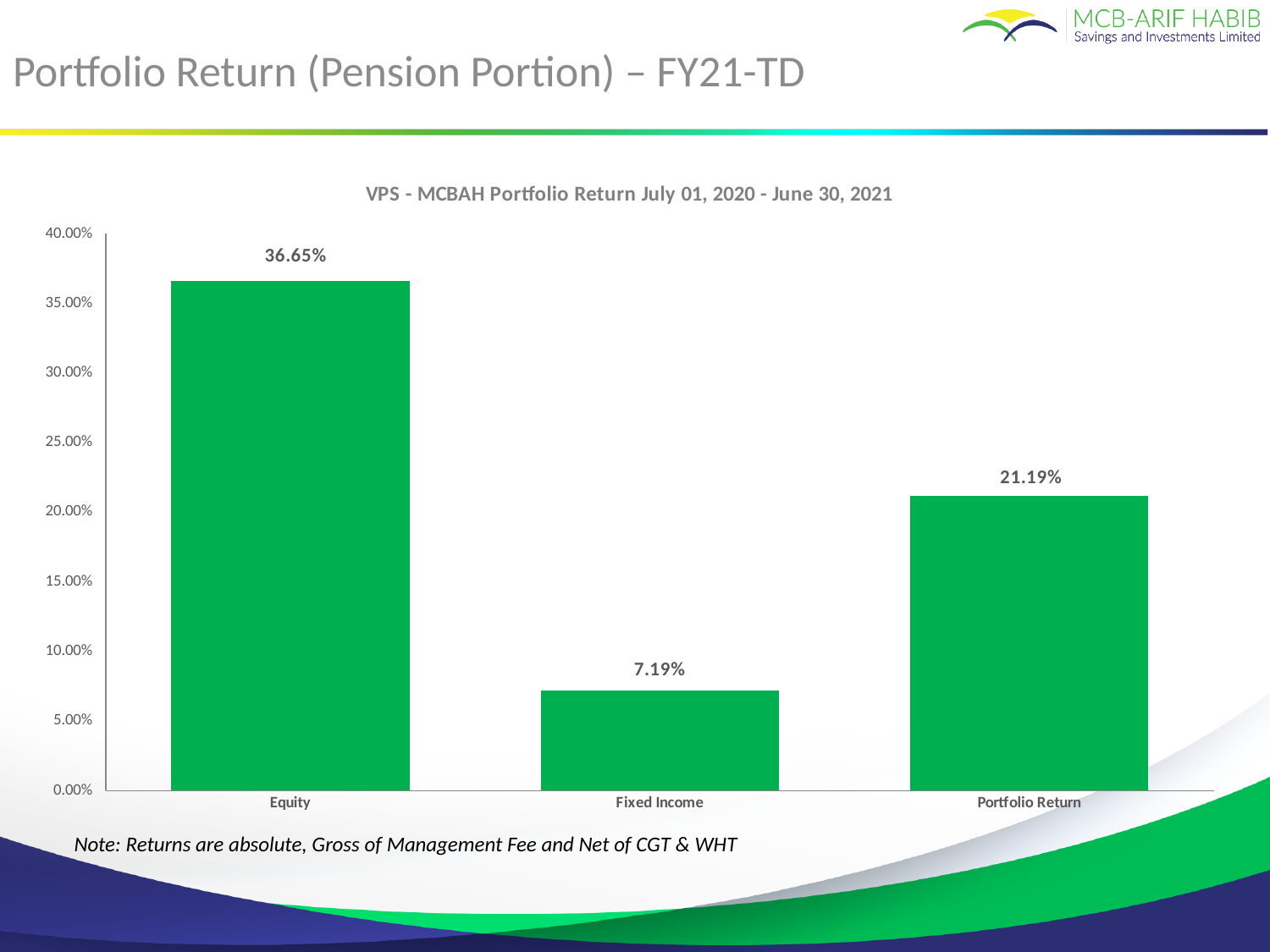
What kind of chart is shown on the slide? Bar chart Which category has the lowest value? Fixed Income Which category has the highest value? Equity What is the difference between the Equity and Fixed Income values? 29.46% What is the value for Equity? 36.65% What is the difference between the Equity and Portfolio Return values? 15.46% Is the value for Portfolio Return greater or less than 20.00%? greater Which is larger, the value for Fixed Income or the value for Portfolio Return? Portfolio Return What is the value for Portfolio Return? 21.19% What is the value for Fixed Income? 7.19% What is the title of the chart? VPS - MCBAH Portfolio Return July 01, 2020 - June 30, 2021 How many categories are shown on the chart? 3